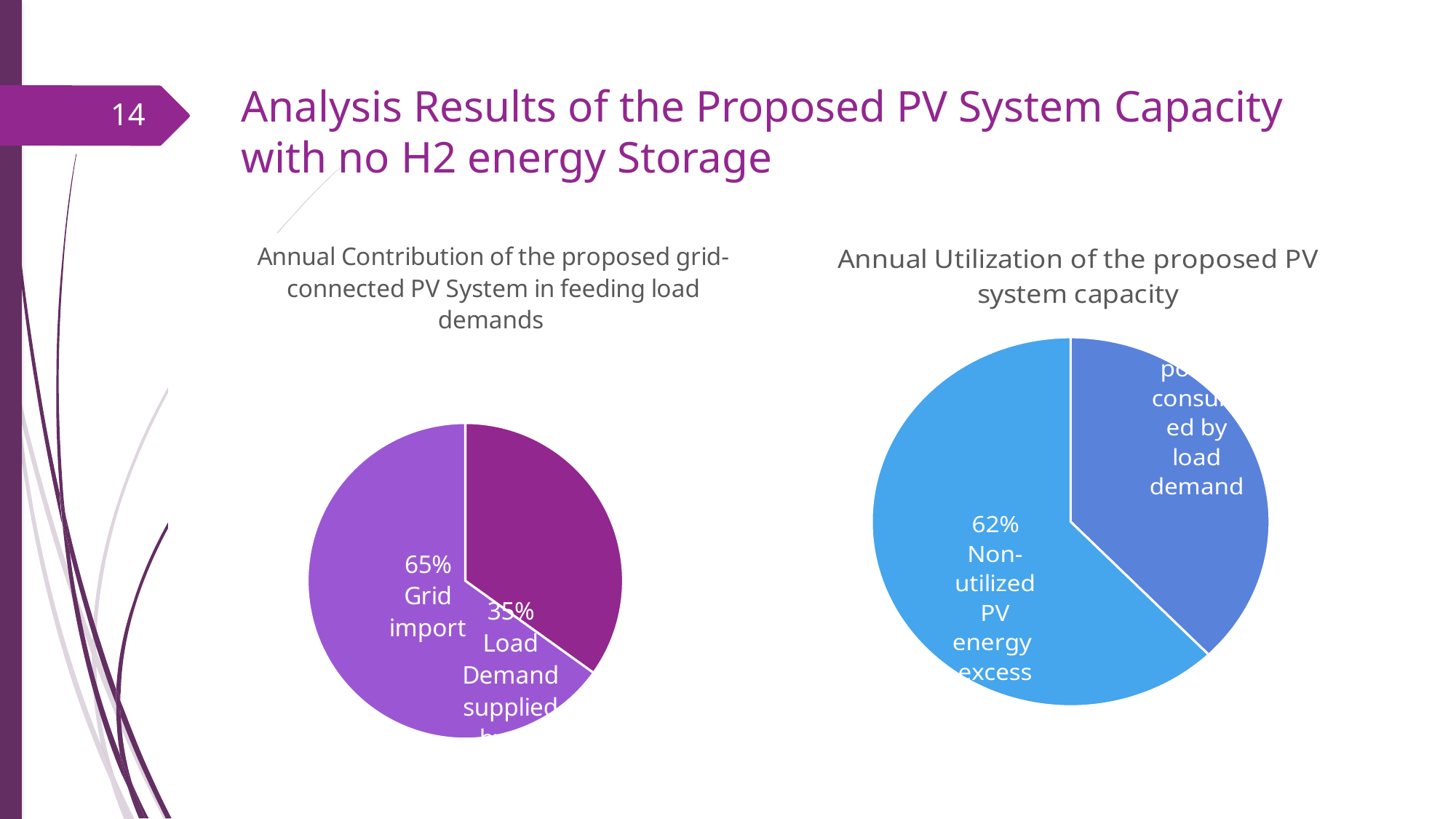
What kind of chart is the left chart, 'Annual Contribution of the proposed grid-connected PV System in feeding load demands'? Pie chart What kind of chart is the right chart, 'Annual Utilization of the proposed PV system capacity'? Pie chart In the right chart (Annual Utilization of the proposed PV system capacity), what share is labelled Non-utilized PV energy excess? 62% In the left chart (Annual Contribution of the proposed grid-connected PV System), what share is labelled Grid import? 65% How many slices does the right chart (Annual Utilization of the proposed PV system capacity) have? 2 In the left chart (Annual Contribution of the proposed grid-connected PV System), which slice is the largest? Grid import In the left chart (Annual Contribution of the proposed grid-connected PV System), which slice is the smallest? Load Demand supplied In the right chart (Annual Utilization of the proposed PV system capacity), which slice is the largest? Non-utilized PV energy excess In the left chart (Annual Contribution of the proposed grid-connected PV System), what share is labelled Load Demand supplied? 35% In the left chart (Annual Contribution of the proposed grid-connected PV System), which is larger: Grid import or Load Demand supplied? Grid import In the left chart (Annual Contribution of the proposed grid-connected PV System), by how many percentage points does Grid import exceed Load Demand supplied? 30 percentage points How many slices does the left chart (Annual Contribution of the proposed grid-connected PV System) have? 2